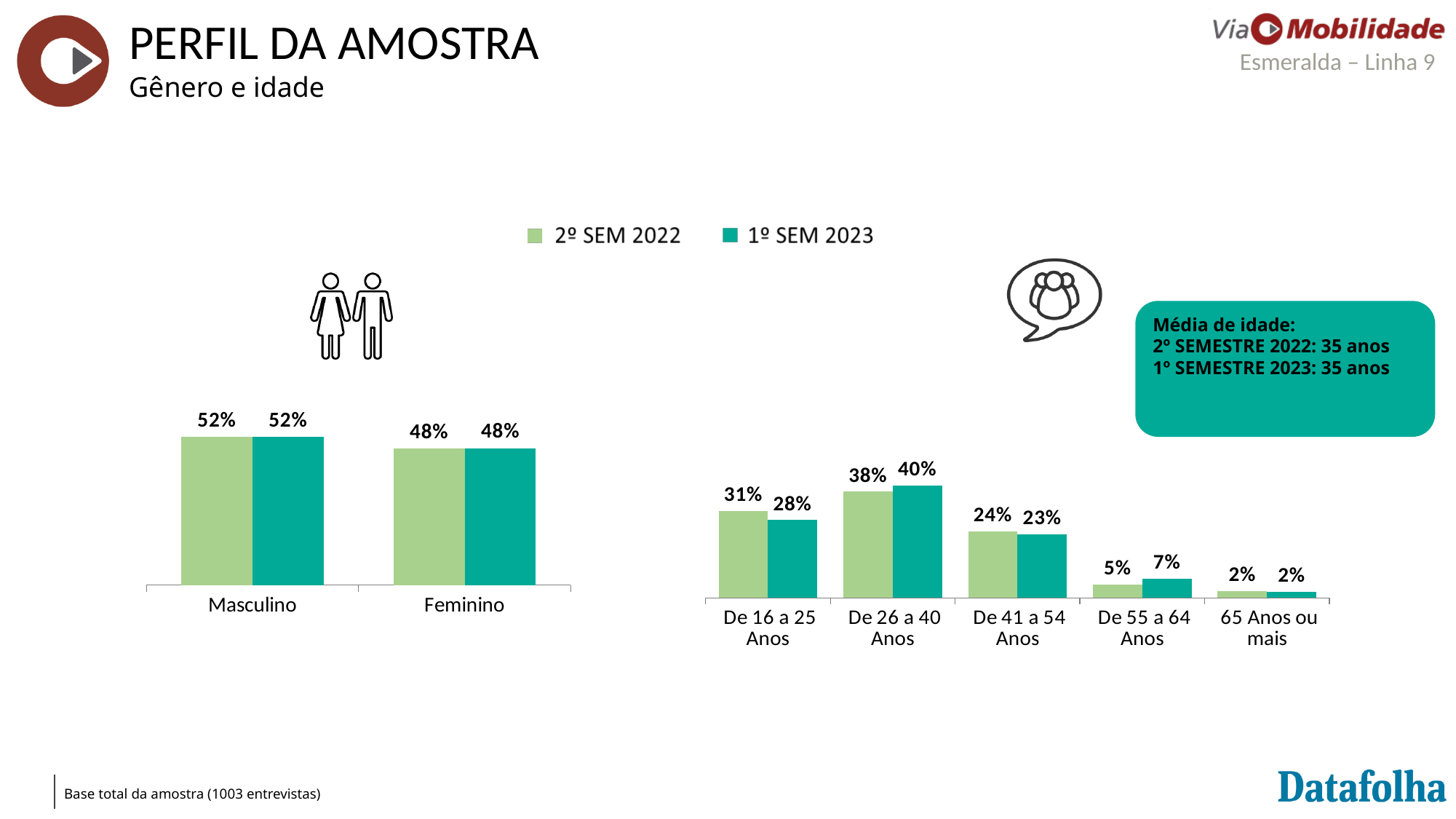
In the age chart on the right, which age group has the lowest value in 1º SEM 2023? 65 Anos ou mais How many age groups are shown in the age chart on the right? 5 In the gender chart on the left, what is the value for Feminino in 2º SEM 2022? 48% In the age chart on the right, which is larger for De 41 a 54 Anos: the 2º SEM 2022 value or the 1º SEM 2023 value? 2º SEM 2022 In the age chart on the right, which age group has the highest value in 2º SEM 2022? De 26 a 40 Anos What kind of chart is the gender chart on the left? Bar chart In the age chart on the right, what is the value for De 26 a 40 Anos in 1º SEM 2023? 40% In the age chart on the right, do the 1º SEM 2023 values rise or fall from De 26 a 40 Anos to 65 Anos ou mais? Fall In the age chart on the right, what is the value for De 55 a 64 Anos in 2º SEM 2022? 5% In the age chart on the right, what is the difference between the 2º SEM 2022 and 1º SEM 2023 values for De 16 a 25 Anos? 3% In the gender chart on the left, what is the value for Masculino in 1º SEM 2023? 52% How many series does the legend list? 2